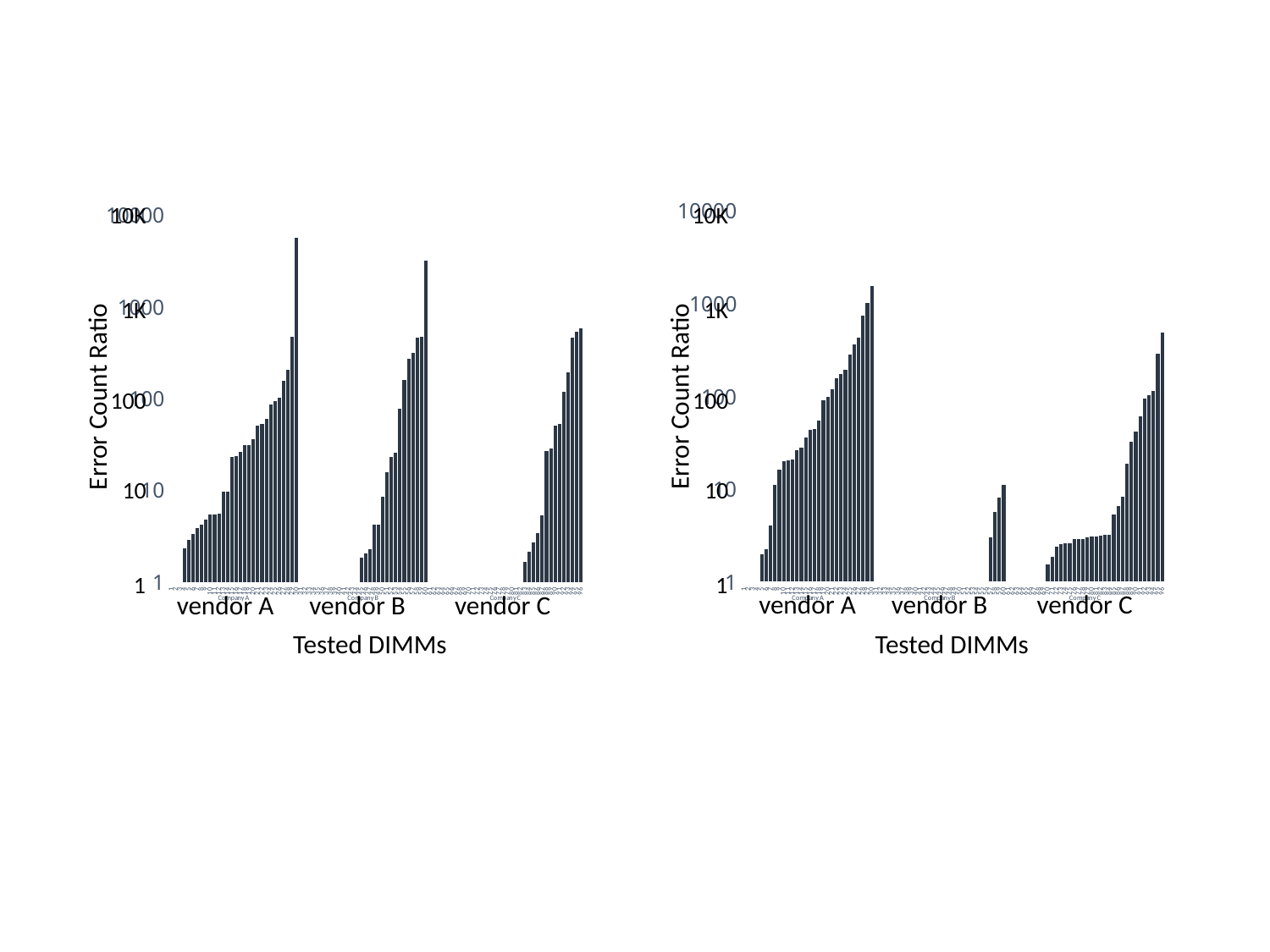
On the left chart, is the tallest bar for vendor A taller or shorter than the tallest bar for vendor C? taller On the right chart, which vendor group has the lowest maximum bar? vendor B On the left chart, do the bars within the vendor B group rise or fall from left to right? rise On the left chart, is the tallest bar in the vendor C group greater or less than 1K? less What kind of chart is the left chart on the slide? bar chart On the left chart, is the tallest bar in the vendor A group greater or less than 1K? greater What is the x-axis label of the right chart? Tested DIMMs How many vendor groups are shown along the x axis of the right chart? 3 On the right chart, which vendor group contains the tallest bar? vendor A On the right chart, is the tallest bar in the vendor A group greater or less than 1K? greater What is the y-axis label of the left chart? Error Count Ratio